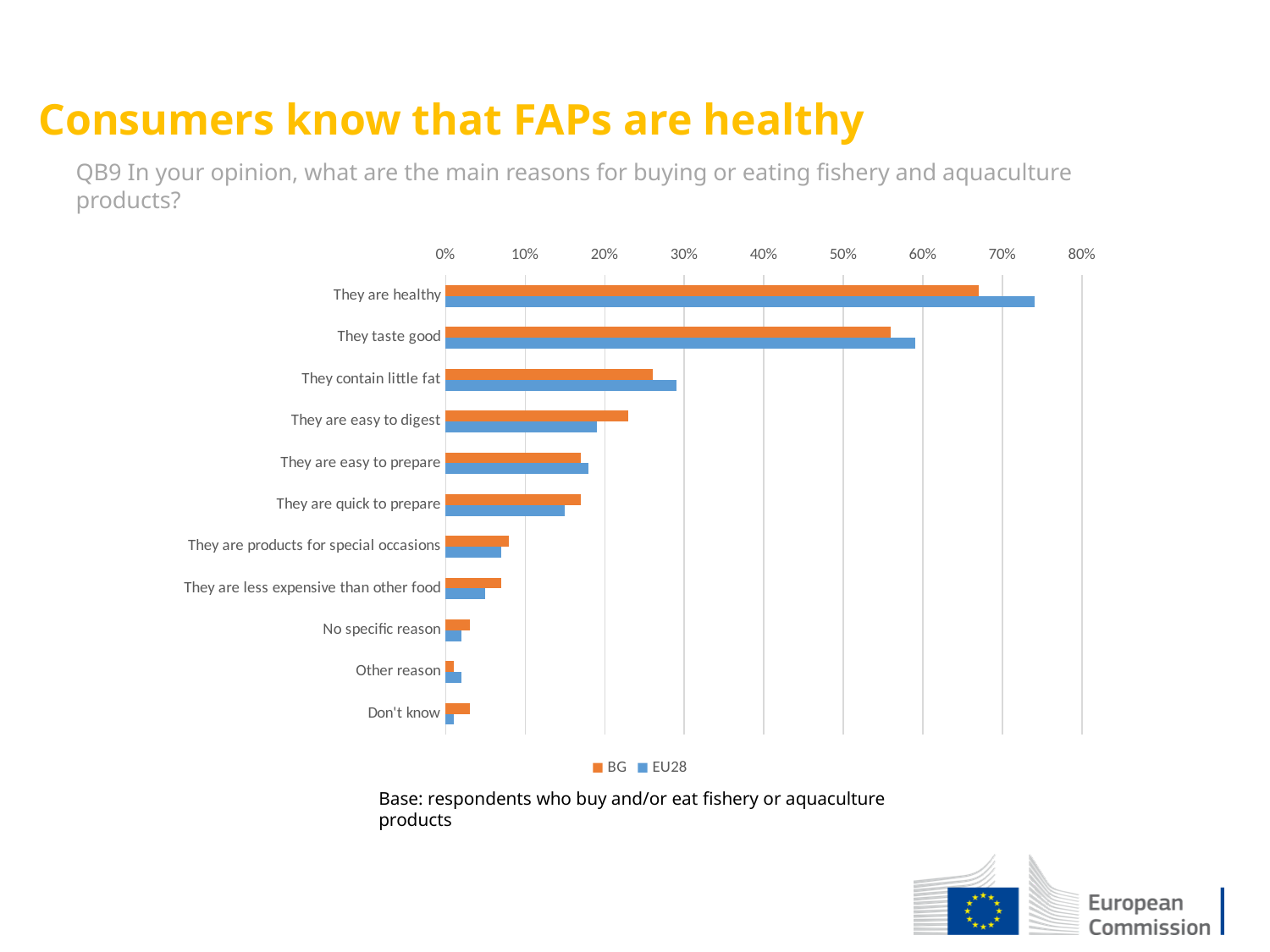
Which category has the lowest value for the BG series? Other reason Is the BG value for 'They are healthy' greater or less than 70%? less For 'They are healthy', which series has the larger value, BG or EU28? EU28 For 'They are easy to digest', which series has the larger value, BG or EU28? BG What kind of chart is shown on the slide? bar chart Which series is shown in orange in the legend? BG How many reason categories are plotted on the chart? 11 Is the BG value for 'They taste good' greater or less than 50%? greater How many series does the legend list? 2 Is the EU28 value for 'They are healthy' greater or less than 70%? greater Which category has the highest value for the EU28 series? They are healthy